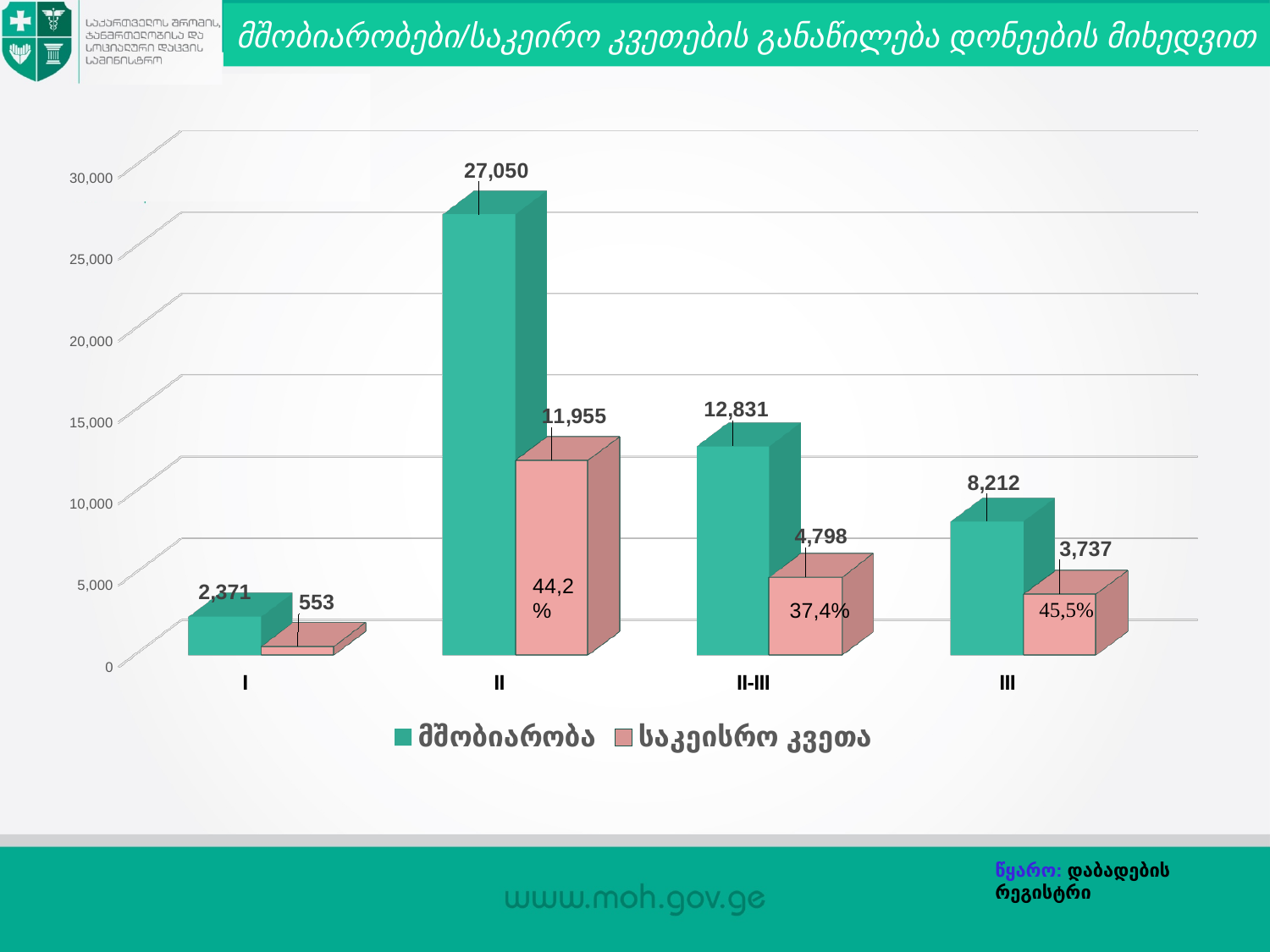
What is the value of საკეისრო კვეთა for level II-III? 4,798 Which level has the lowest საკეისრო კვეთა value? I What is the value of საკეისრო კვეთა for level I? 553 What kind of chart is shown on the slide? bar chart What is the difference between მშობიარობა and საკეისრო კვეთა for level II? 15,095 What is the value of მშობიარობა for level II? 27,050 Which level has the highest მშობიარობა value? II How many series does the legend list? 2 What percentage label is shown inside the საკეისრო კვეთა bar for level III? 45,5% Which is larger: საკეისრო კვეთა for level II-III or for level III? II-III What is the value of მშობიარობა for level III? 8,212 How many levels are shown on the x axis? 4